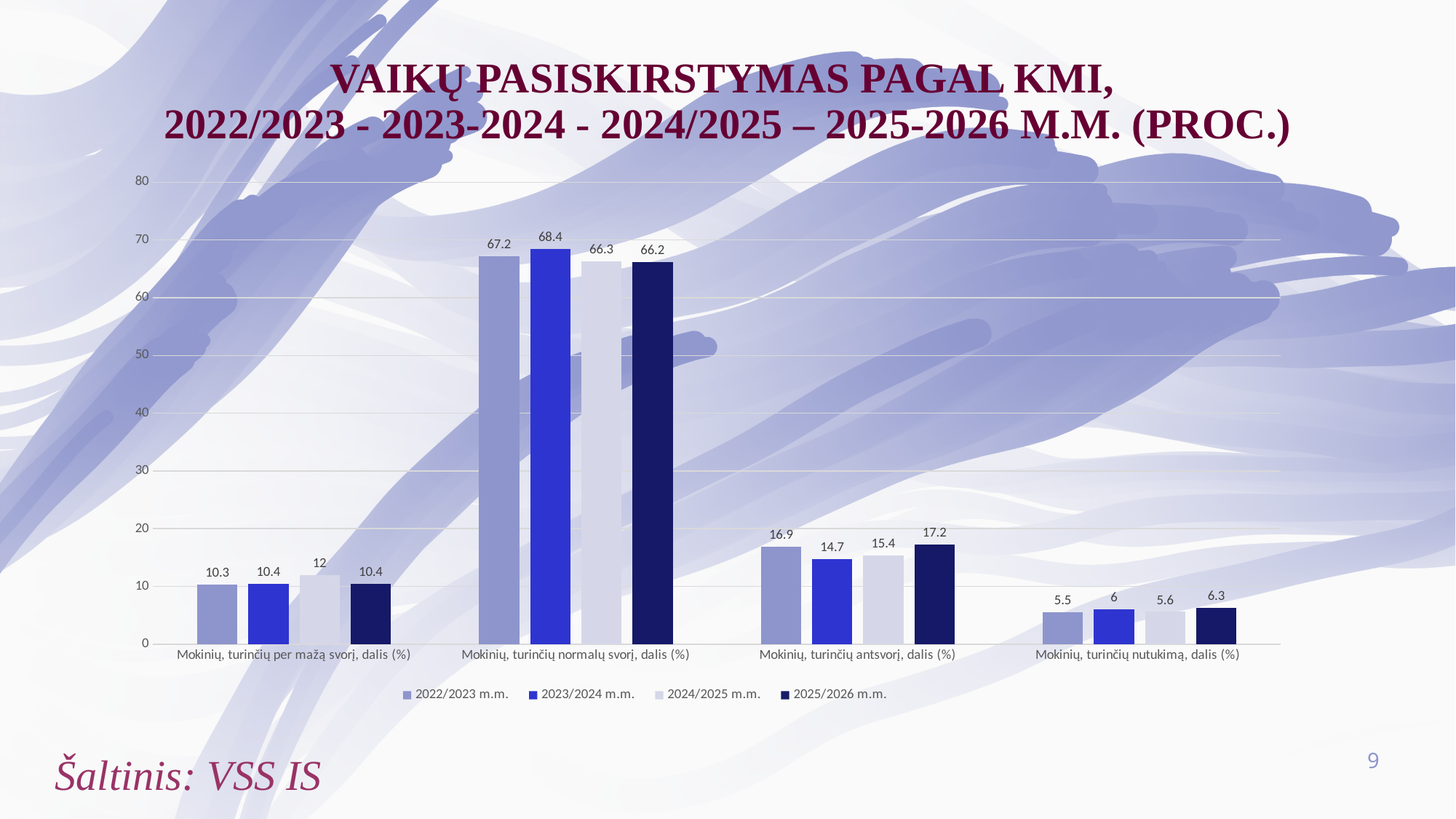
What is the difference between the 2022/2023 m.m. and 2025/2026 m.m. values in the category 'Mokinių, turinčių antsvorį, dalis (%)'? 0.3 Which is larger: the 2022/2023 m.m. value or the 2024/2025 m.m. value in the category 'Mokinių, turinčių normalų svorį, dalis (%)'? 2022/2023 m.m. What is the value for 2024/2025 m.m. in the category 'Mokinių, turinčių per mažą svorį, dalis (%)'? 12 Which series has the highest value in the category 'Mokinių, turinčių antsvorį, dalis (%)'? 2025/2026 m.m. What type of chart is shown on the slide? Bar chart Which series has the lowest value in the category 'Mokinių, turinčių antsvorį, dalis (%)'? 2023/2024 m.m. What is the value for 2023/2024 m.m. in the category 'Mokinių, turinčių normalų svorį, dalis (%)'? 68.4 What is the value for 2025/2026 m.m. in the category 'Mokinių, turinčių nutukimą, dalis (%)'? 6.3 How many categories are shown on the x axis? 4 Which category has the highest values across all series? Mokinių, turinčių normalų svorį, dalis (%) Is the value for 2023/2024 m.m. in the category 'Mokinių, turinčių nutukimą, dalis (%)' greater or less than 10? less How many series does the legend list? 4